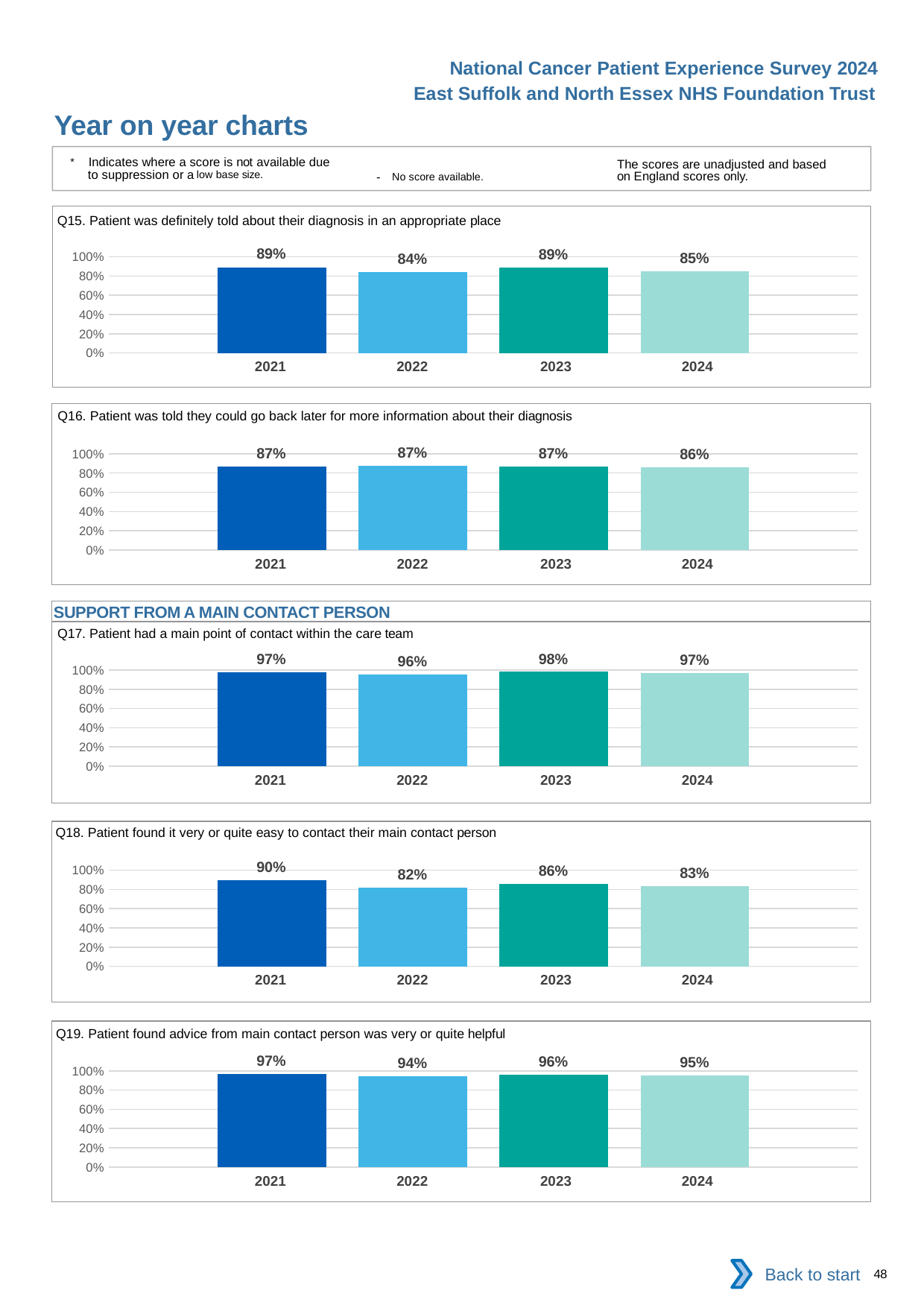
In the Q18 chart, is the value for 2022 greater or less than 80%? greater In the Q17 chart (patient had a main point of contact within the care team), which year has the highest value? 2023 In the Q19 chart, what is the value for 2021? 97% In the Q16 chart (patient was told they could go back later for more information), what is the value for 2024? 86% What is the section heading shown above the Q17 chart? SUPPORT FROM A MAIN CONTACT PERSON In the Q18 chart, what is the difference between the 2021 and 2024 values? 7% In the Q15 chart (patient was definitely told about their diagnosis in an appropriate place), what is the value for 2022? 84% What kind of chart is the Q17 chart? Bar chart In the Q18 chart (patient found it very or quite easy to contact their main contact person), which year has the lowest value? 2022 In the Q19 chart (patient found advice from main contact person was very or quite helpful), which is larger, the value for 2022 or the value for 2023? 2023 In the Q15 chart, how many years are plotted? 4 In the Q15 chart, what is the difference between the 2023 and 2024 values? 4%